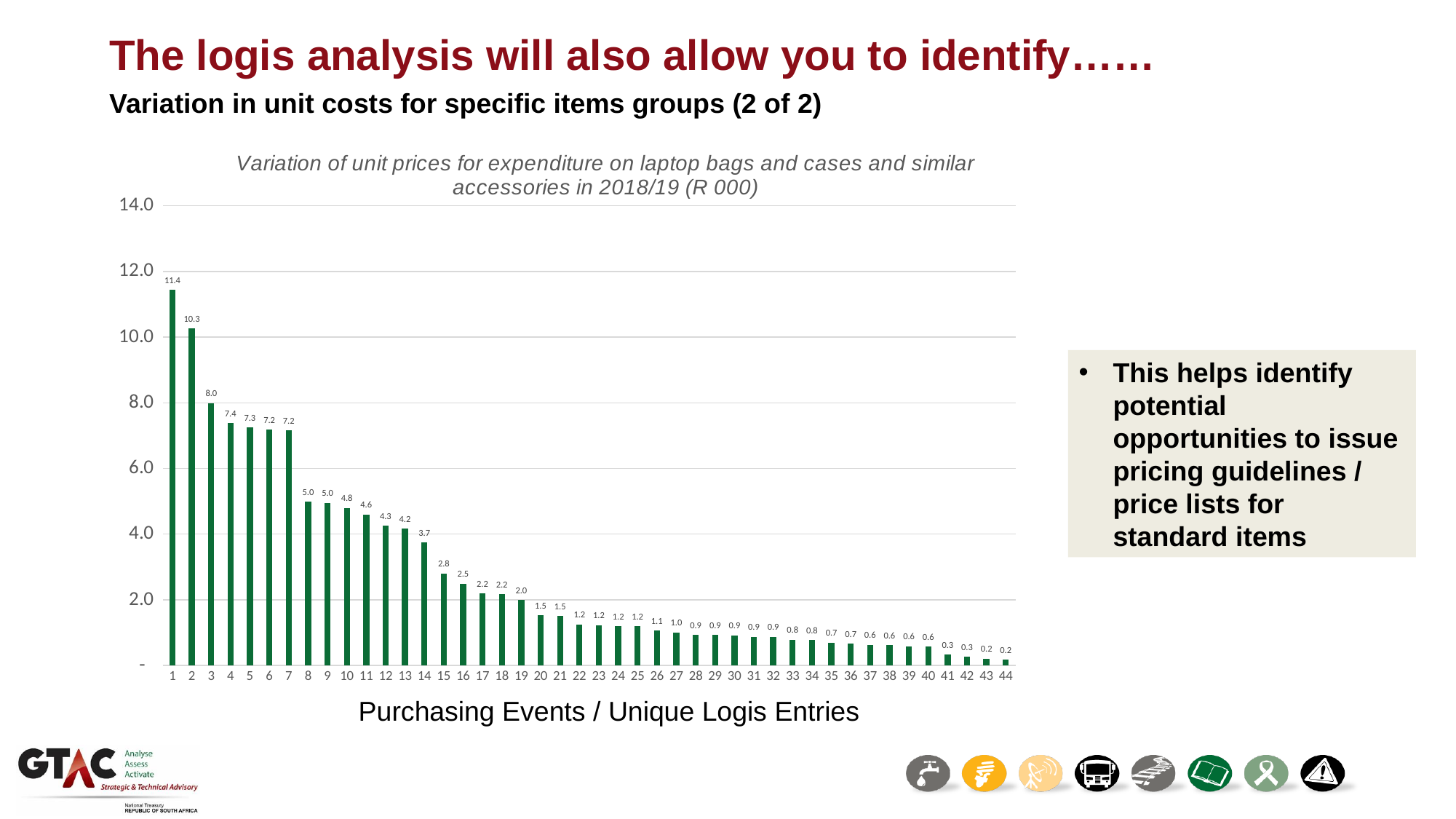
What is the difference between the values for purchasing events 1 and 2? 1.1 What is the value for purchasing event 3? 8.0 Which is larger, the value for purchasing event 3 or purchasing event 8? Purchasing event 3 What is the value for purchasing event 14? 3.7 What kind of chart is shown on the slide? Bar chart What is the value for purchasing event 19? 2.0 Is the value for purchasing event 1 greater or less than 10.0? greater Do the values rise or fall from purchasing event 1 to purchasing event 44? Fall How many purchasing events are plotted on the chart? 44 What is the value for purchasing event 1? 11.4 What is the lowest unit price value shown on the chart? 0.2 Which purchasing event has the highest unit price? 1